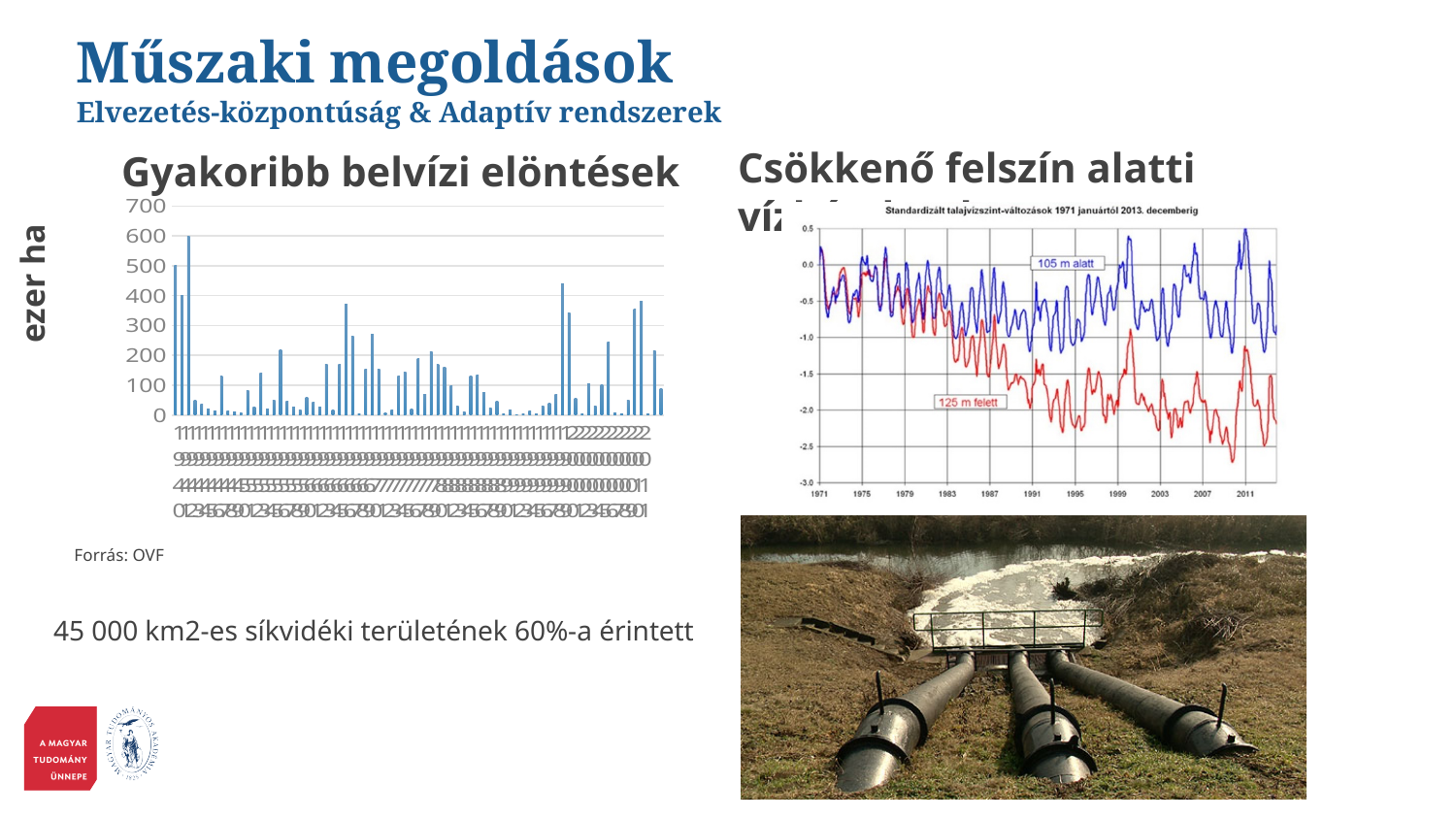
What is the lowest value shown on the y-axis of the 'Standardizált talajvízszint-változások' line chart? -3.0 In the 'Standardizált talajvízszint-változások' line chart, which series is labelled in red? 125 m felett In the 'Gyakoribb belvízi elöntések' bar chart, is the tallest bar greater or less than 500? greater What is the highest value shown on the y-axis of the 'Gyakoribb belvízi elöntések' bar chart? 700 In the 'Standardizált talajvízszint-változások' line chart, which series reaches lower values overall, '105 m alatt' or '125 m felett'? 125 m felett How many series are plotted in the 'Standardizált talajvízszint-változások' line chart on the right? 2 What kind of chart is the 'Standardizált talajvízszint-változások' chart on the right? line chart What kind of chart is the 'Gyakoribb belvízi elöntések' chart on the left? bar chart In the 'Standardizált talajvízszint-változások' line chart, do the values of the '125 m felett' series generally rise or fall from 1971 to 2011? fall What is the y-axis label of the 'Gyakoribb belvízi elöntések' bar chart? ezer ha What is the first year shown on the x-axis of the 'Standardizált talajvízszint-változások' line chart? 1971 In the 'Gyakoribb belvízi elöntések' bar chart, is the tallest bar greater or less than 700? less